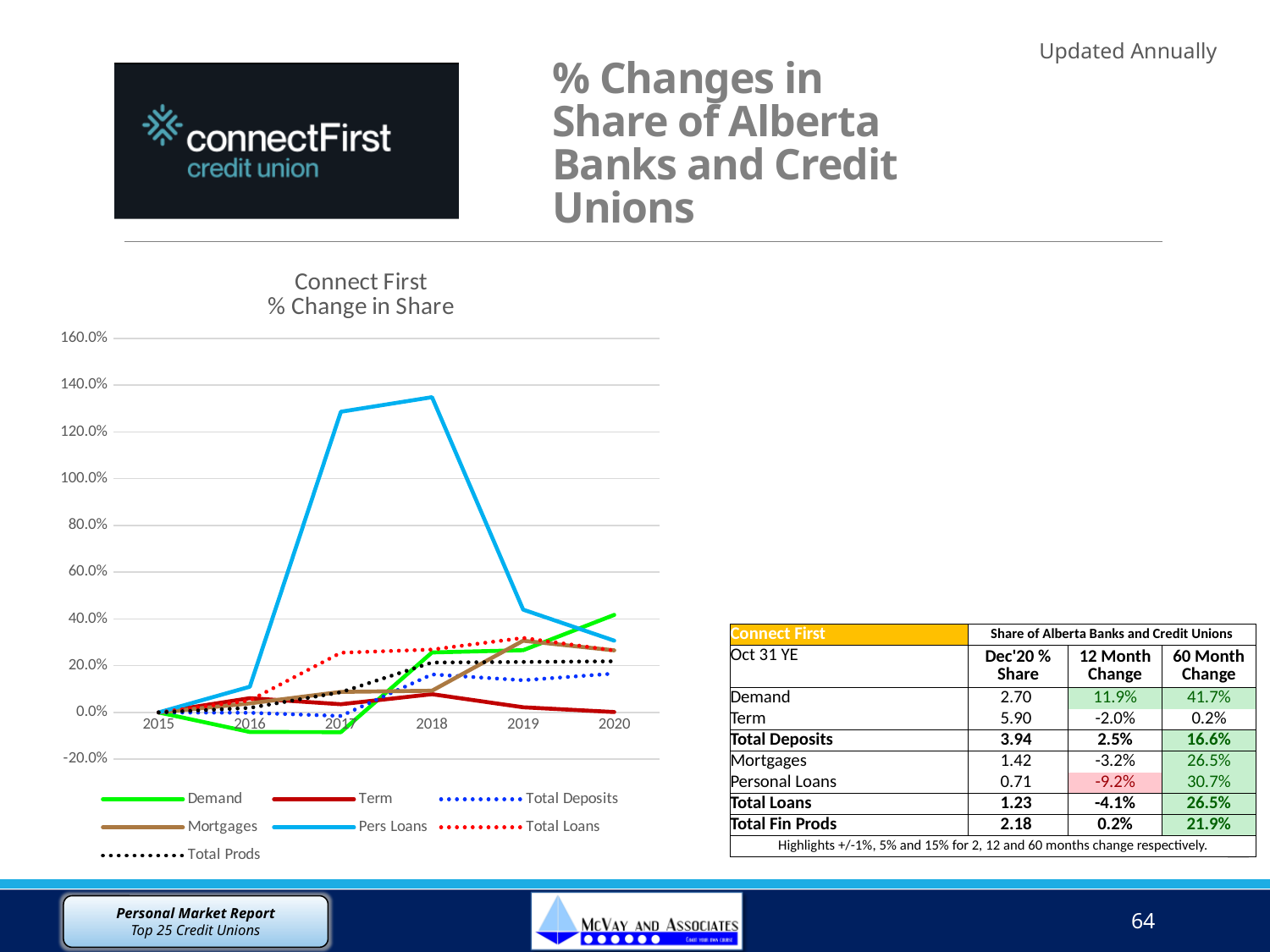
What is the title of the chart? Connect First % Change in Share What kind of chart is shown on the slide? line chart Is the value for Demand in 2020 greater or less than 20.0%? greater Does the Pers Loans line rise or fall from 2018 to 2020? fall Is the value for Pers Loans in 2018 greater or less than 120.0%? greater How many series does the legend of the chart list? 7 Is the value for Demand in 2016 greater or less than 0.0%? less How many years are plotted along the x axis of the chart? 6 In 2020, which is larger: the value for Demand or the value for Term? Demand Which series reaches the highest value on the chart? Pers Loans